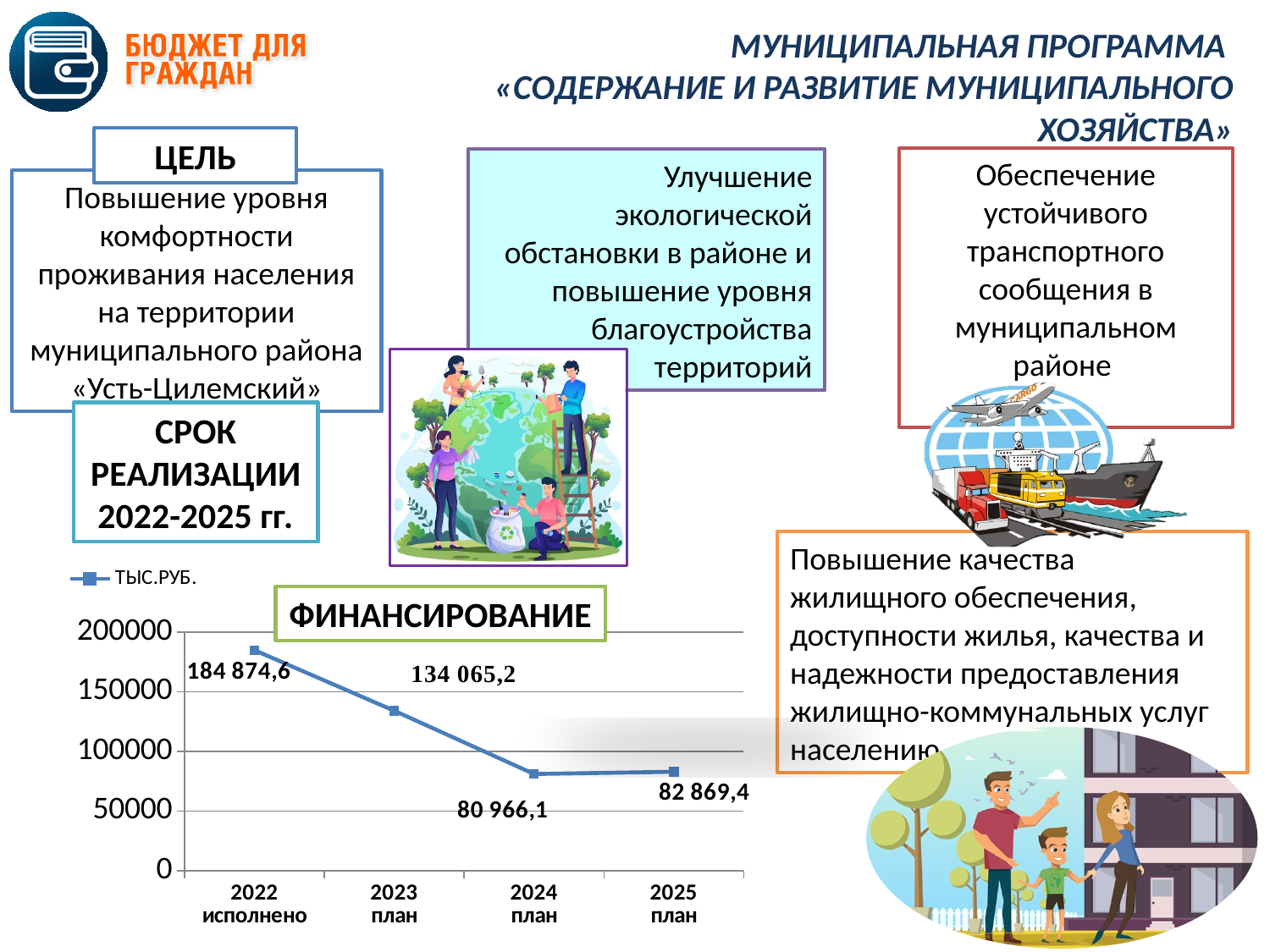
What is the value for 2025 план on the ФИНАНСИРОВАНИЕ chart? 82 869,4 What is the difference between the values for 2022 исполнено and 2023 план on the ФИНАНСИРОВАНИЕ chart? 50 809,4 What is the value for 2022 исполнено on the ФИНАНСИРОВАНИЕ chart? 184 874,6 Which is larger on the ФИНАНСИРОВАНИЕ chart: the value for 2024 план or 2025 план? 2025 план What unit does the legend of the ФИНАНСИРОВАНИЕ chart show? ТЫС.РУБ. How many data points are plotted on the ФИНАНСИРОВАНИЕ chart? 4 What is the value for 2023 план on the ФИНАНСИРОВАНИЕ chart? 134 065,2 What kind of chart is the ФИНАНСИРОВАНИЕ chart? line chart What is the value for 2024 план on the ФИНАНСИРОВАНИЕ chart? 80 966,1 Is the value for 2023 план on the ФИНАНСИРОВАНИЕ chart greater or less than 150000? less Which year has the highest value on the ФИНАНСИРОВАНИЕ chart? 2022 исполнено Which year has the lowest value on the ФИНАНСИРОВАНИЕ chart? 2024 план